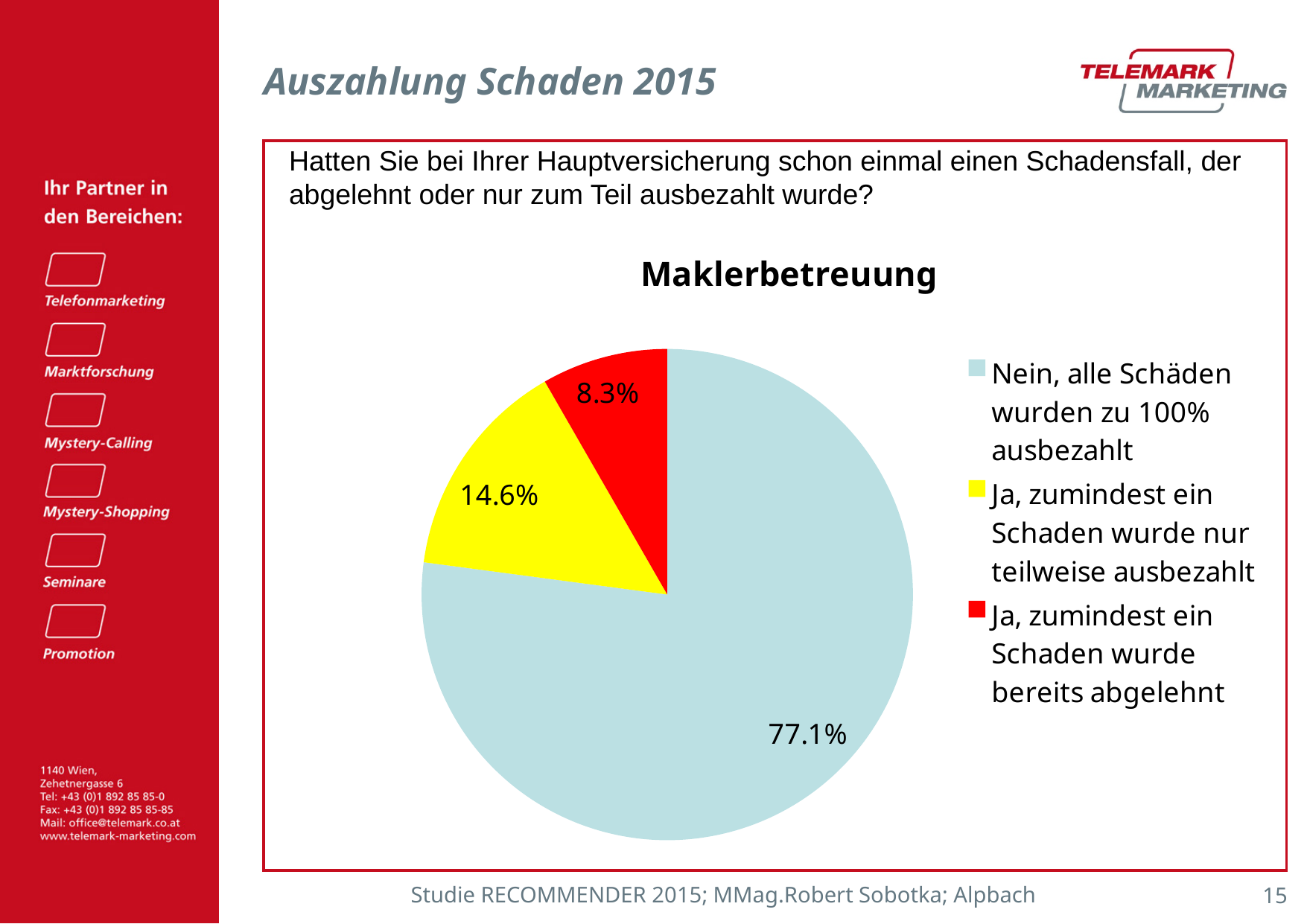
How many slices does the pie chart have? 3 Which is larger: the slice for 'Ja, zumindest ein Schaden wurde nur teilweise ausbezahlt' or the slice for 'Ja, zumindest ein Schaden wurde bereits abgelehnt'? Ja, zumindest ein Schaden wurde nur teilweise ausbezahlt Which category has the smallest slice of the pie? Ja, zumindest ein Schaden wurde bereits abgelehnt What kind of chart is shown on the slide? pie chart Which category has the largest slice of the pie? Nein, alle Schäden wurden zu 100% ausbezahlt How many entries does the legend list? 3 What colour is the slice for 'Ja, zumindest ein Schaden wurde bereits abgelehnt'? red What share of the pie is labelled 'Ja, zumindest ein Schaden wurde bereits abgelehnt'? 8.3% What share of the pie is labelled 'Ja, zumindest ein Schaden wurde nur teilweise ausbezahlt'? 14.6% What is the title of the chart? Maklerbetreuung What is the difference between the 'Nein, alle Schäden wurden zu 100% ausbezahlt' slice and the 'Ja, zumindest ein Schaden wurde nur teilweise ausbezahlt' slice? 62.5% What share of the pie is labelled 'Nein, alle Schäden wurden zu 100% ausbezahlt'? 77.1%